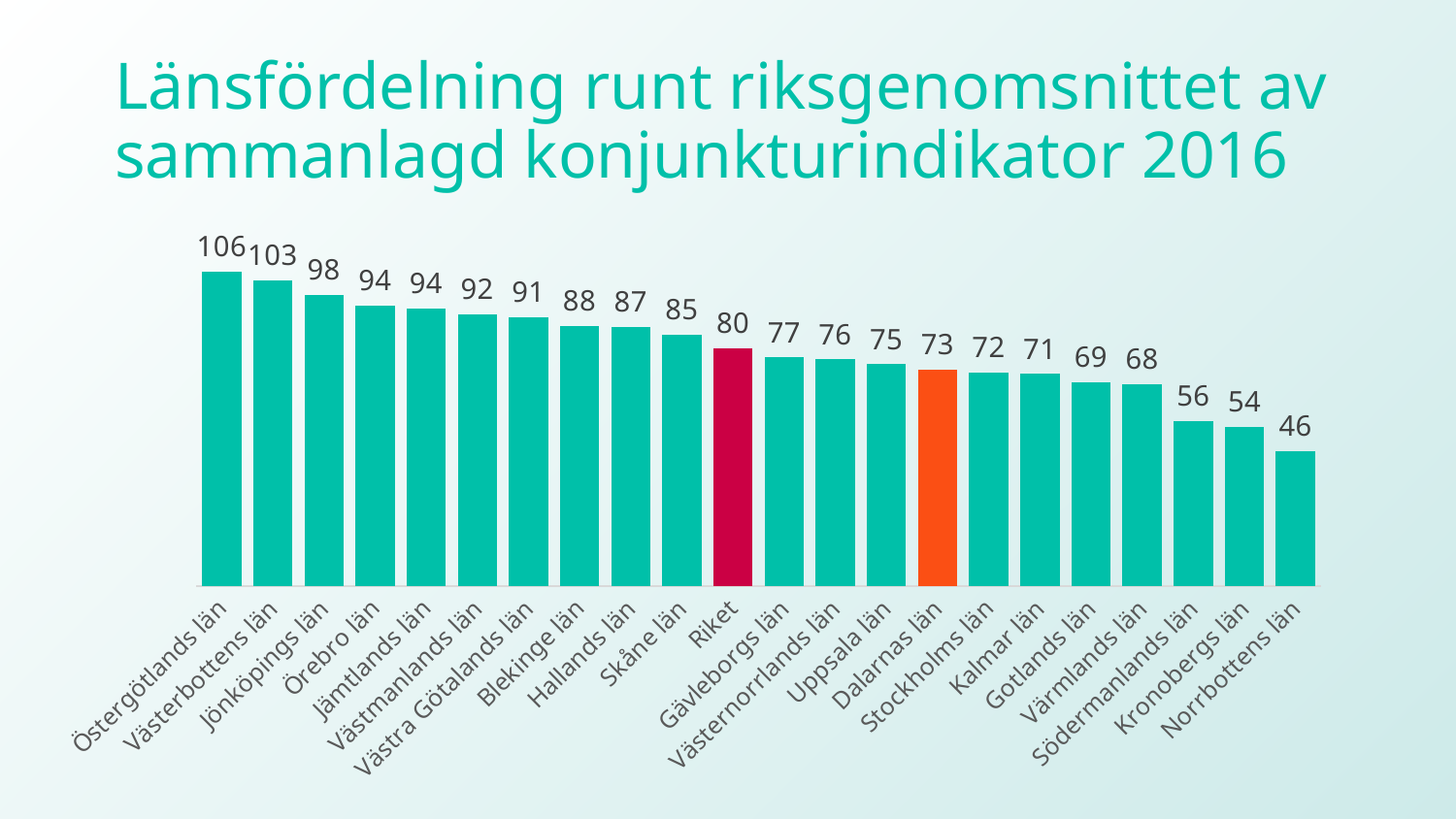
Do the values rise or fall from left to right along the x axis? Fall What kind of chart is shown on the slide? Bar chart Which bar is coloured orange? Dalarnas län How many bars are shown in the chart? 22 What is the value for Dalarnas län? 73 What is the difference between the values for Riket and Dalarnas län? 7 Which category has the lowest value? Norrbottens län What is the value for Riket? 80 What is the difference between the values for Östergötlands län and Norrbottens län? 60 What is the value for Stockholms län? 72 Which is larger, the value for Skåne län or the value for Gävleborgs län? Skåne län Which category has the highest value? Östergötlands län